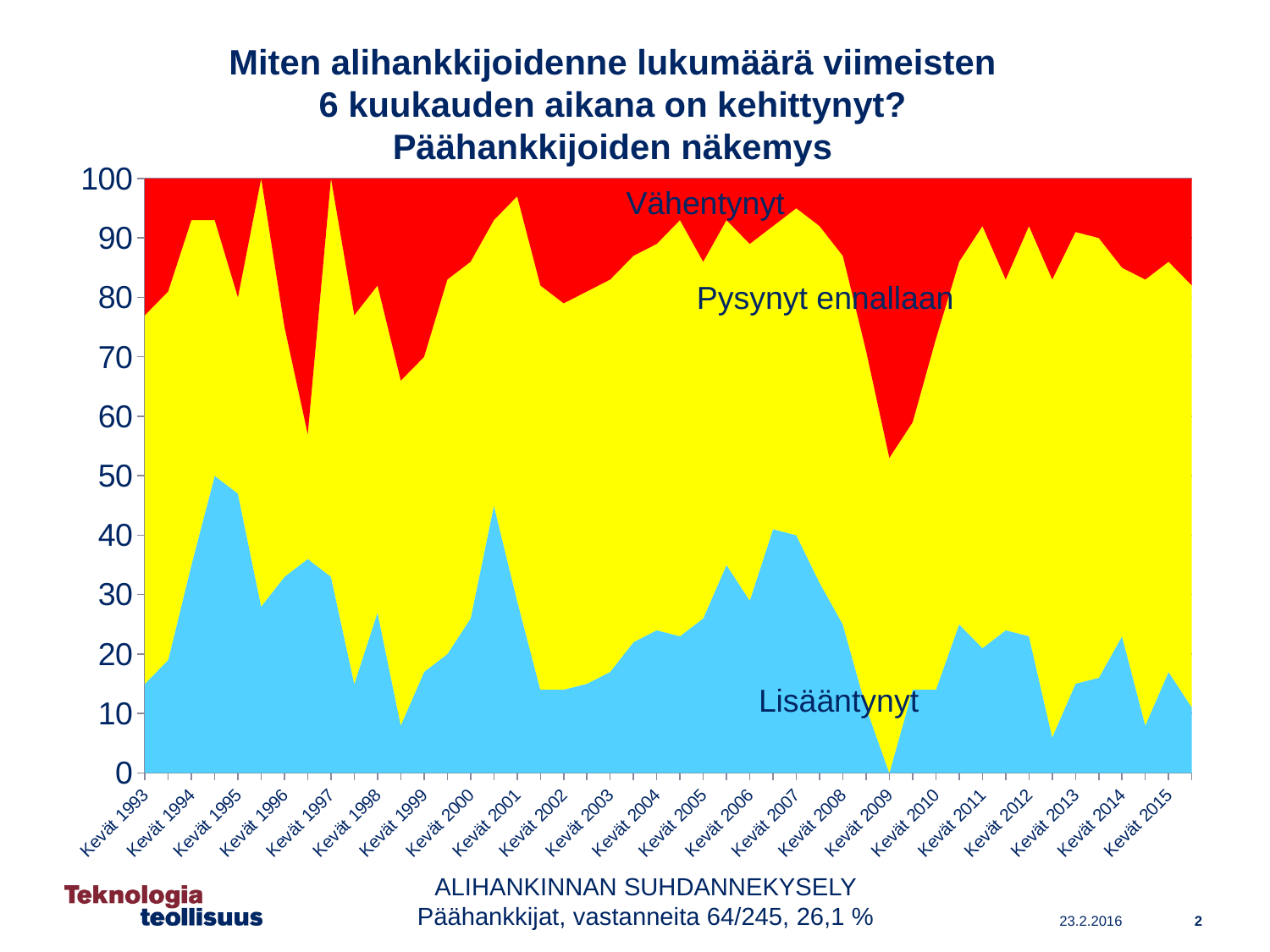
Is the value for Lisääntynyt at Kevät 2003 greater or less than 30? less What colour is the Lisääntynyt series? Blue Which series is plotted at the top of the stack? Vähentynyt How many labelled points (Kevät years) are on the x axis? 23 How many series does the chart show? 3 At Kevät 2003, which is larger: Pysynyt ennallaan or Lisääntynyt? Pysynyt ennallaan Which series takes the largest share at Kevät 2015? Pysynyt ennallaan Does the Lisääntynyt series rise or fall from Kevät 2007 to Kevät 2009? Fall What kind of chart is shown on the slide? Stacked area chart Is the value for Lisääntynyt at Kevät 2009 greater or less than 10? less Is the value for Vähentynyt at Kevät 2009 greater or less than 30? greater